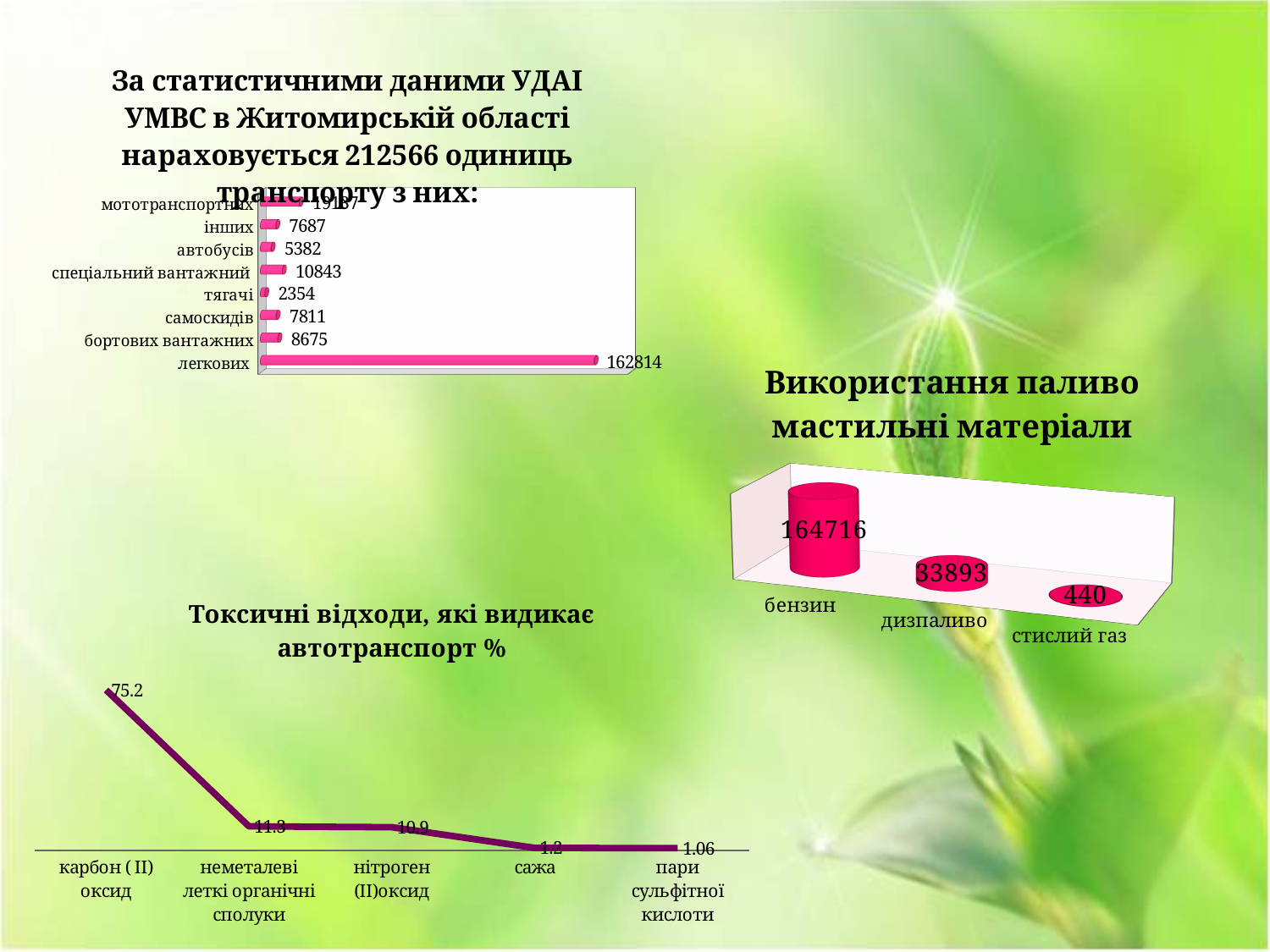
In the top-left bar chart of vehicle types, which is larger: інших or автобусів? інших How many categories are shown in the top-left bar chart of vehicle types? 8 In the top-left bar chart of vehicle types, what is the value for спеціальний вантажний? 10843 In the chart 'Токсичні відходи, які видикає автотранспорт %', do the values rise or fall from left to right along the x axis? fall What kind of chart is the top-left chart of vehicle types? bar chart In the top-left bar chart of vehicle types, what is the difference between бортових вантажних and самоскидів? 864 In the top-left bar chart of vehicle types, what is the value for легкових? 162814 In the top-left bar chart of vehicle types, which category has the lowest value? тягачі In the chart 'Використання паливо мастильні матеріали', what is the value for дизпаливо? 33893 In the chart 'Використання паливо мастильні матеріали', which category has the highest value? бензин In the chart 'Токсичні відходи, які видикає автотранспорт %', what is the value for карбон (II) оксид? 75.2 In the chart 'Використання паливо мастильні матеріали', what is the difference between бензин and стислий газ? 164276